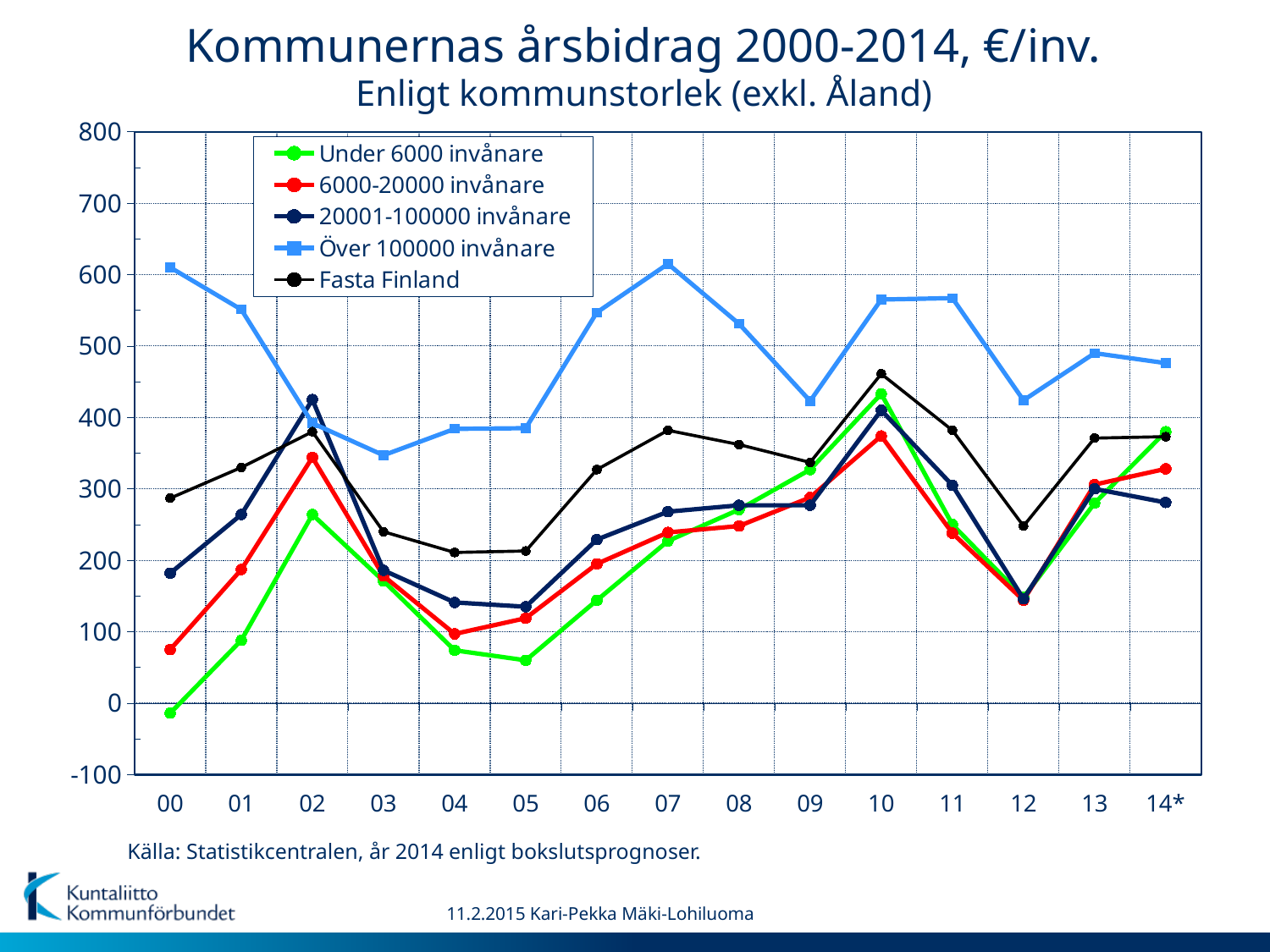
In 02, which is higher: 20001-100000 invånare or Över 100000 invånare? 20001-100000 invånare Is the value for Fasta Finland in 10 greater or less than 400? greater What colour is the line for Fasta Finland? black How many years are shown along the x axis? 15 Is the value for Över 100000 invånare in 00 greater or less than 500? greater Does the value for Under 6000 invånare rise or fall from 10 to 12? fall Is the value for Under 6000 invånare in 05 greater or less than 100? less Which series has the lowest value in 00? Under 6000 invånare What kind of chart is shown on the slide? line chart How many series does the legend list? 5 In which year is the value for Under 6000 invånare lowest? 00